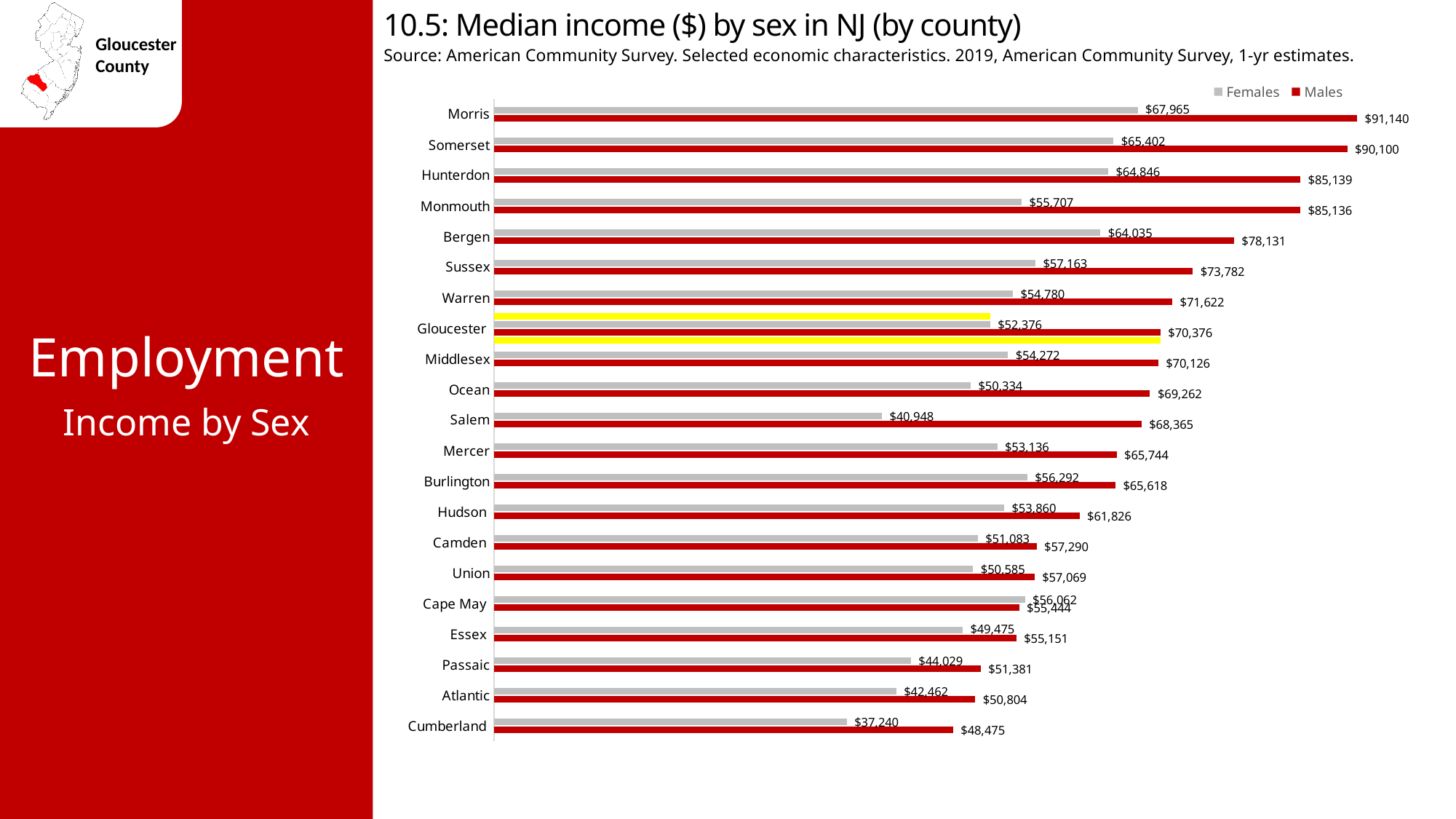
What kind of chart is shown on the slide? Bar chart What is the median income for females in Morris County? $67,965 What is the median income for males in Gloucester County? $70,376 What is the median income for females in Salem County? $40,948 Which county has the highest median income for males? Morris Which county has the lowest median income for females? Cumberland How many series does the legend list? 2 What is the difference between male and female median income in Morris County? $23,175 What is the difference between male and female median income in Gloucester County? $18,000 In Cape May County, which is larger: the median income for females or for males? Females How many counties are shown in the chart? 21 Which is larger: the median income for males in Hunterdon or in Monmouth? Hunterdon